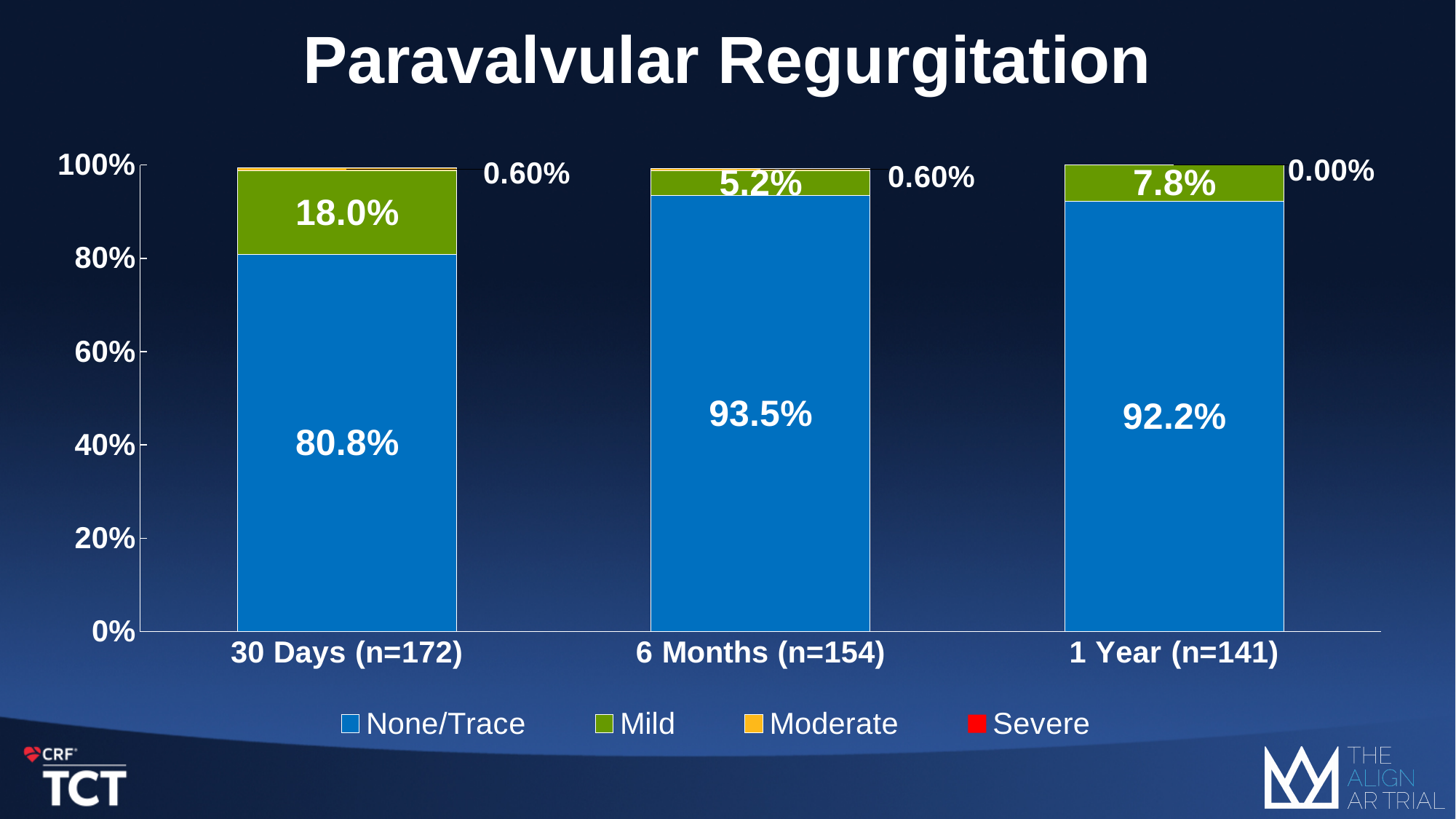
Which is larger: the None/Trace value at 6 Months (n=154) or at 1 Year (n=141)? 6 Months (n=154) How many series does the legend list? 4 What is the title of the chart? Paravalvular Regurgitation What is the None/Trace value at 1 Year (n=141)? 92.2% How many time points are shown on the x axis? 3 At which time point is the Mild value highest? 30 Days (n=172) What is the Mild value at 1 Year (n=141)? 7.8% What is the difference between the Mild value at 30 Days (n=172) and at 1 Year (n=141)? 10.2% What is the None/Trace value at 30 Days (n=172)? 80.8% What type of chart is shown on the slide? Stacked bar chart At which time point is the None/Trace value lowest? 30 Days (n=172) What is the Mild value at 6 Months (n=154)? 5.2%